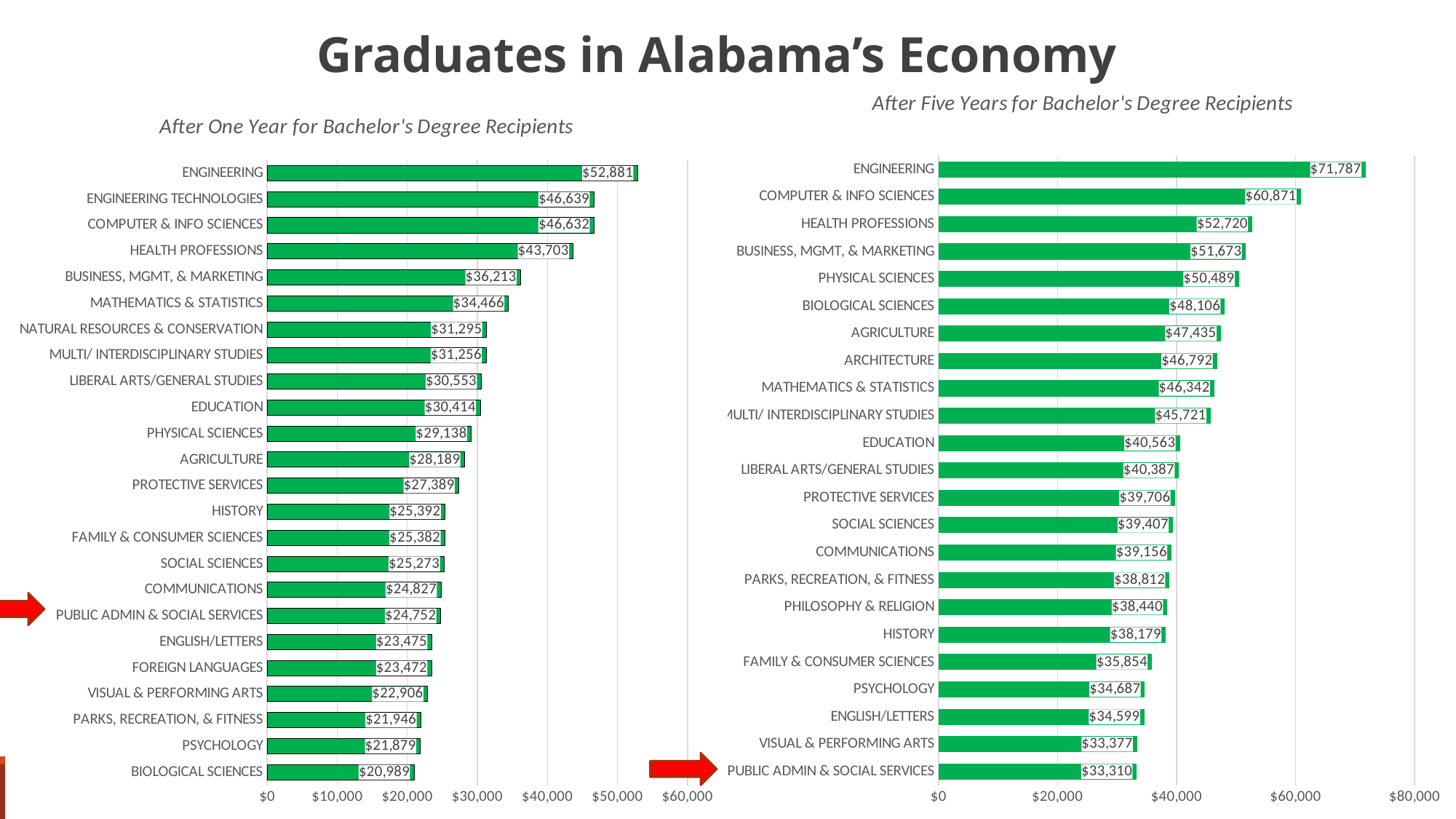
How many categories are shown in the 'After Five Years for Bachelor's Degree Recipients' chart? 23 In the 'After One Year for Bachelor's Degree Recipients' chart, which is larger: Health Professions or Business, Mgmt, & Marketing? Health Professions How many categories are shown in the 'After One Year for Bachelor's Degree Recipients' chart? 24 In the 'After Five Years for Bachelor's Degree Recipients' chart, what is the difference between Engineering and Computer & Info Sciences? $10,916 What type of chart is the 'After Five Years for Bachelor's Degree Recipients' chart? Bar chart In the 'After One Year for Bachelor's Degree Recipients' chart, is the value for Mathematics & Statistics greater or less than $30,000? greater In the 'After One Year for Bachelor's Degree Recipients' chart, which category has the lowest value? Biological Sciences In the 'After Five Years for Bachelor's Degree Recipients' chart, which category has the lowest value? Public Admin & Social Services In the 'After One Year for Bachelor's Degree Recipients' chart, what is the value for Public Admin & Social Services? $24,752 In the 'After One Year for Bachelor's Degree Recipients' chart, which category has the highest value? Engineering In the 'After Five Years for Bachelor's Degree Recipients' chart, what is the value for Engineering? $71,787 In the 'After Five Years for Bachelor's Degree Recipients' chart, what is the value for Public Admin & Social Services? $33,310